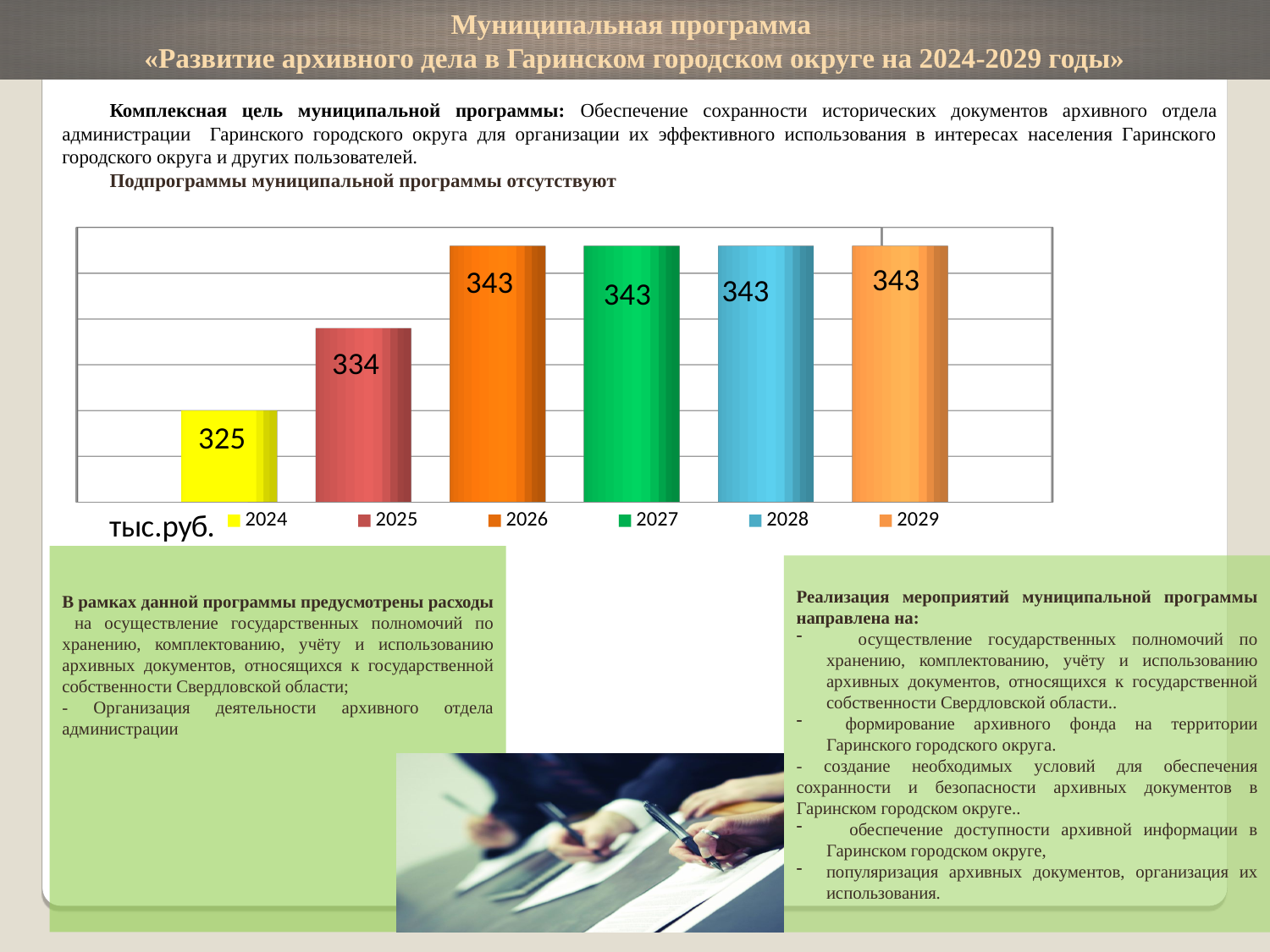
What is the value for 2025 in the bar chart? 334 What kind of chart is shown on the slide? bar chart Which is larger, the value for 2025 or the value for 2024? 2025 What is the difference between the values for 2026 and 2024? 18 What is the difference between the values for 2025 and 2024? 9 What is the highest value shown in the bar chart? 343 How many bars are shown in the chart? 6 Do the values rise or fall from 2024 to 2026? rise How many entries does the chart legend list? 6 What is the value for 2027 in the bar chart? 343 Which year has the lowest value in the bar chart? 2024 What is the value for 2024 in the bar chart? 325